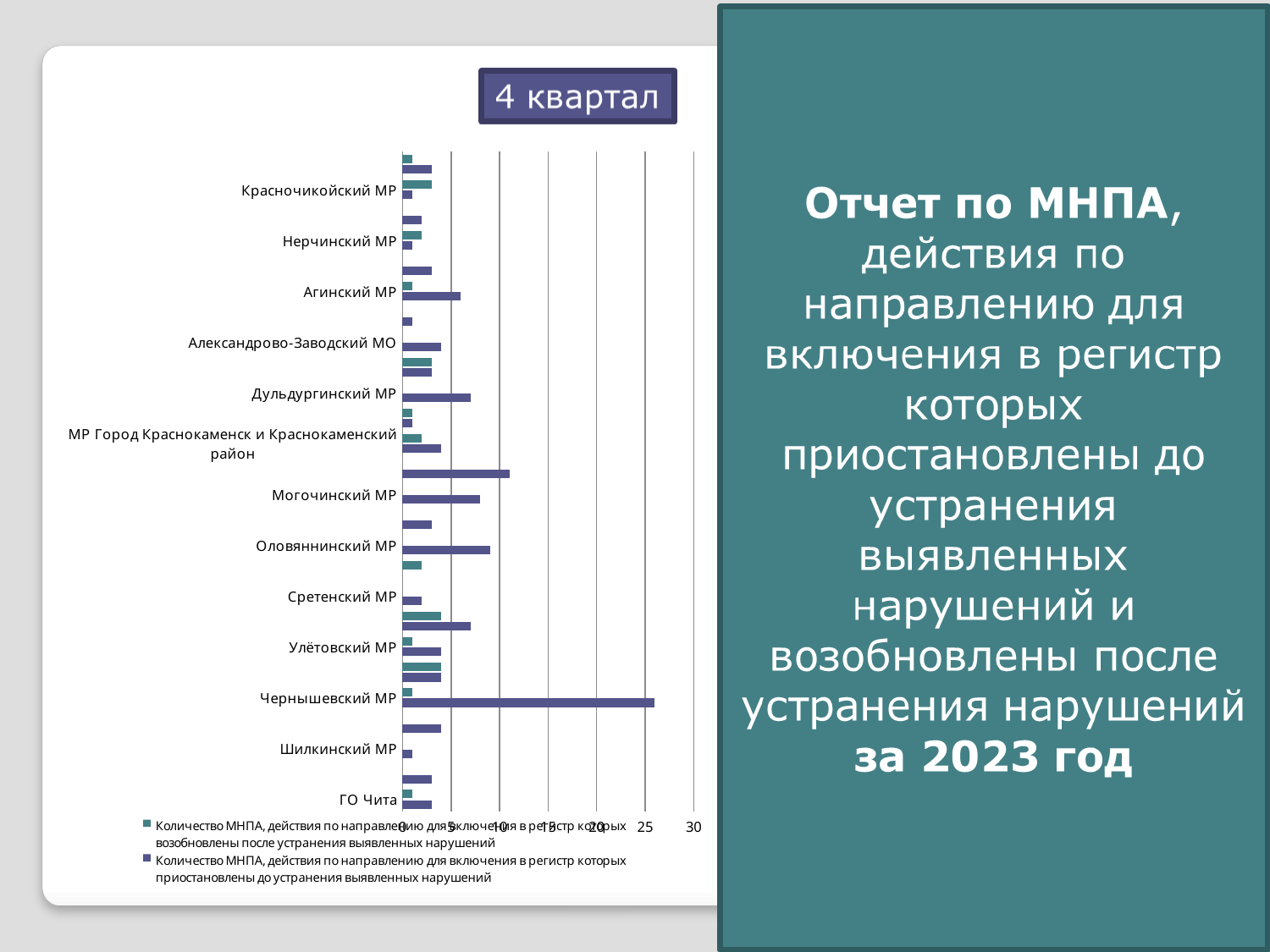
How many series does the chart legend list? 2 Is the value of the longest bar for Шилкинский МР greater or less than 5? less What is the highest value shown on the horizontal axis of the chart? 30 What kind of chart is shown on the slide? bar chart Which is larger: the longest bar for Чернышевский МР or the longest bar for Оловяннинский МР? Чернышевский МР Is the value of the longest bar for Чернышевский МР greater or less than 20? greater What is the title of the chart? 4 квартал Is the value of the longest bar for Чернышевский МР greater or less than 30? less Which category has the longest bar in the chart? Чернышевский МР